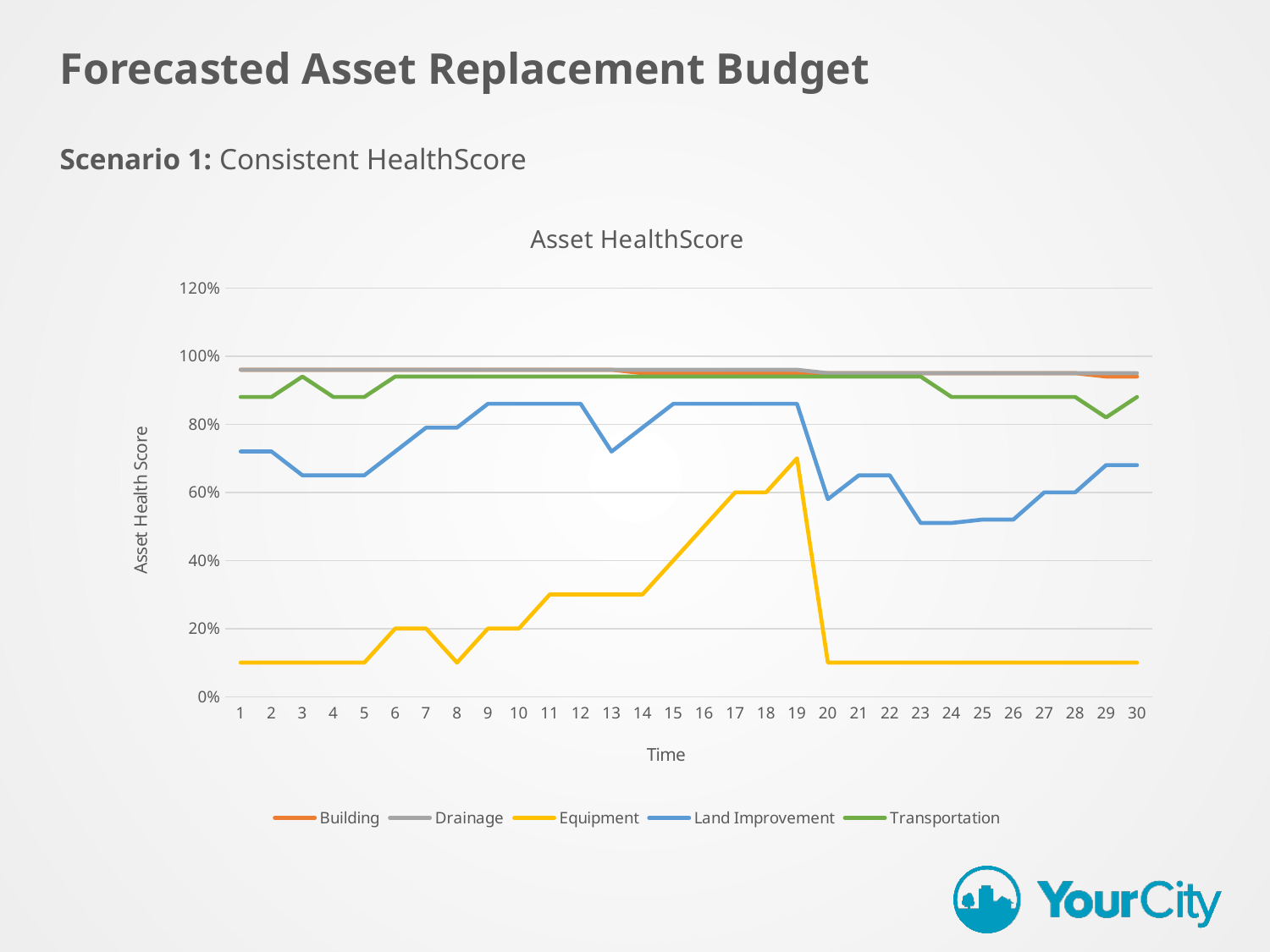
Which is larger: Land Improvement at time 9 or Land Improvement at time 20? Land Improvement at time 9 What is the label of the vertical axis? Asset Health Score Does the Equipment series rise or fall between time 8 and time 19? rise How many series does the legend list? 5 What kind of chart is shown on the slide? Line chart What is the title of the chart? Asset HealthScore Is the value for Land Improvement at time 1 greater or less than 80%? less Which series has the lowest value at time 19? Equipment Is the value for Equipment at time 19 greater or less than 60%? greater At which time point does the Equipment series reach its highest value? 19 How many time points are plotted along the x axis? 30 Is the value for Land Improvement at time 23 greater or less than 60%? less